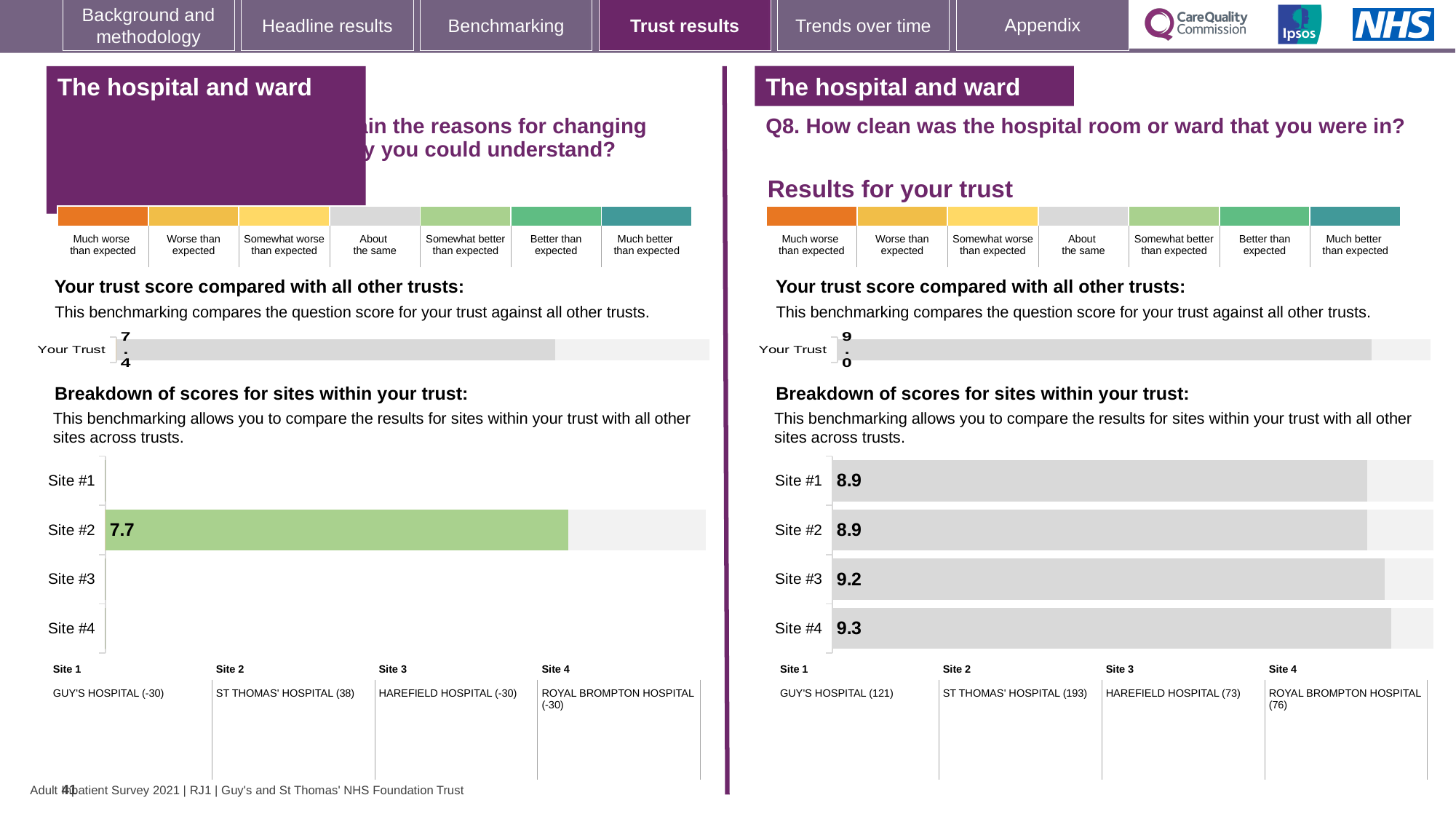
On the right-hand chart (Q8, breakdown of scores for sites), what is the difference between the scores for Site #4 and Site #1? 0.4 On the right-hand chart (Q8, breakdown of scores for sites), how many sites are listed? 4 On the right-hand chart (Q8, breakdown of scores for sites), what is the score for Site #1? 8.9 On the right-hand chart (Q8, breakdown of scores for sites), which has the higher score, Site #2 or Site #3? Site #3 On the left-hand side, what is the 'Your Trust' score compared with all other trusts? 7.4 What kind of chart is the left-hand breakdown of scores for sites within your trust? Bar chart On the right-hand side (Q8), what is the 'Your Trust' score compared with all other trusts? 9.0 On the left-hand chart (breakdown of scores for sites), what colour is the bar for Site #2? Green On the left-hand chart (breakdown of scores for sites), what is the score for Site #2? 7.7 On the right-hand chart (Q8, breakdown of scores for sites), what is the score for Site #4? 9.3 On the right-hand chart (Q8, breakdown of scores for sites), what is the score for Site #3? 9.2 On the right-hand chart (Q8, breakdown of scores for sites), which site has the highest score? Site #4